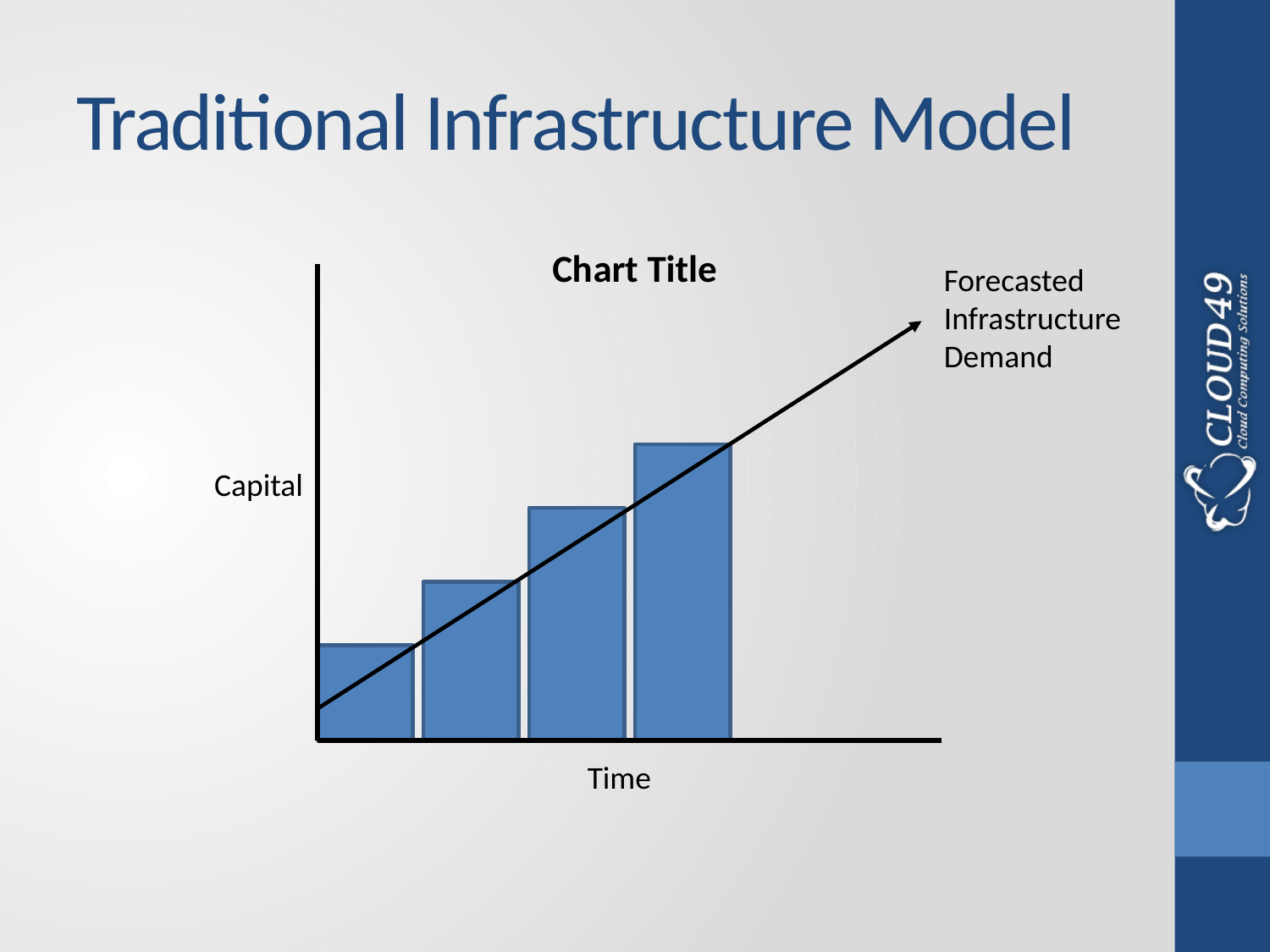
What is the title shown above the chart? Chart Title Do the bar heights rise or fall from left to right along the Time axis? Rise Which is taller, the first bar or the fourth bar? The fourth bar Which bar is the shortest in the chart? The leftmost (first) bar How many bars are plotted in the chart? 4 Which bar is the tallest in the chart? The rightmost (fourth) bar What label is attached to the diagonal arrow drawn across the chart? Forecasted Infrastructure Demand Which is taller, the second bar from the left or the third bar from the left? The third bar What kind of chart is shown on the slide? Bar chart